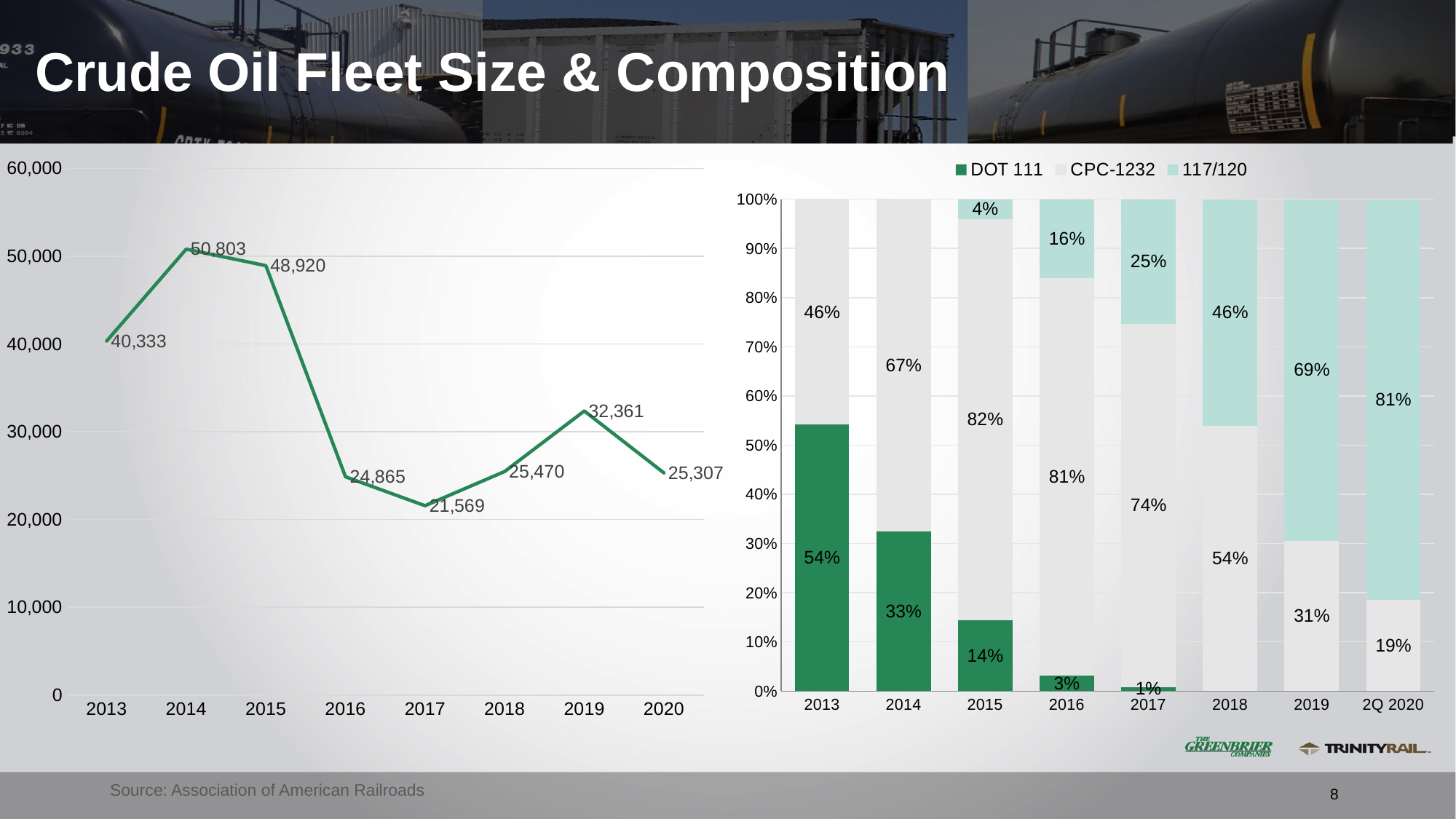
On the right stacked bar chart, what is the DOT 111 share in 2013? 54% On the left line chart, how many years are plotted? 8 On the left line chart, does the value rise or fall from 2015 to 2016? fall On the left line chart, what is the value for 2014? 50,803 On the left line chart, is the value for 2019 greater or less than 30,000? greater On the left line chart, which year has the lowest value? 2017 What kind of chart is on the right side of the slide? Stacked bar chart On the right stacked bar chart, which is larger in 2019: the CPC-1232 share or the 117/120 share? 117/120 On the left line chart, what is the difference between the 2014 value and the 2020 value? 25,496 On the right stacked bar chart, how many series does the legend list? 3 On the right stacked bar chart, what is the 117/120 share in 2Q 2020? 81% On the left line chart, which year has the highest value? 2014